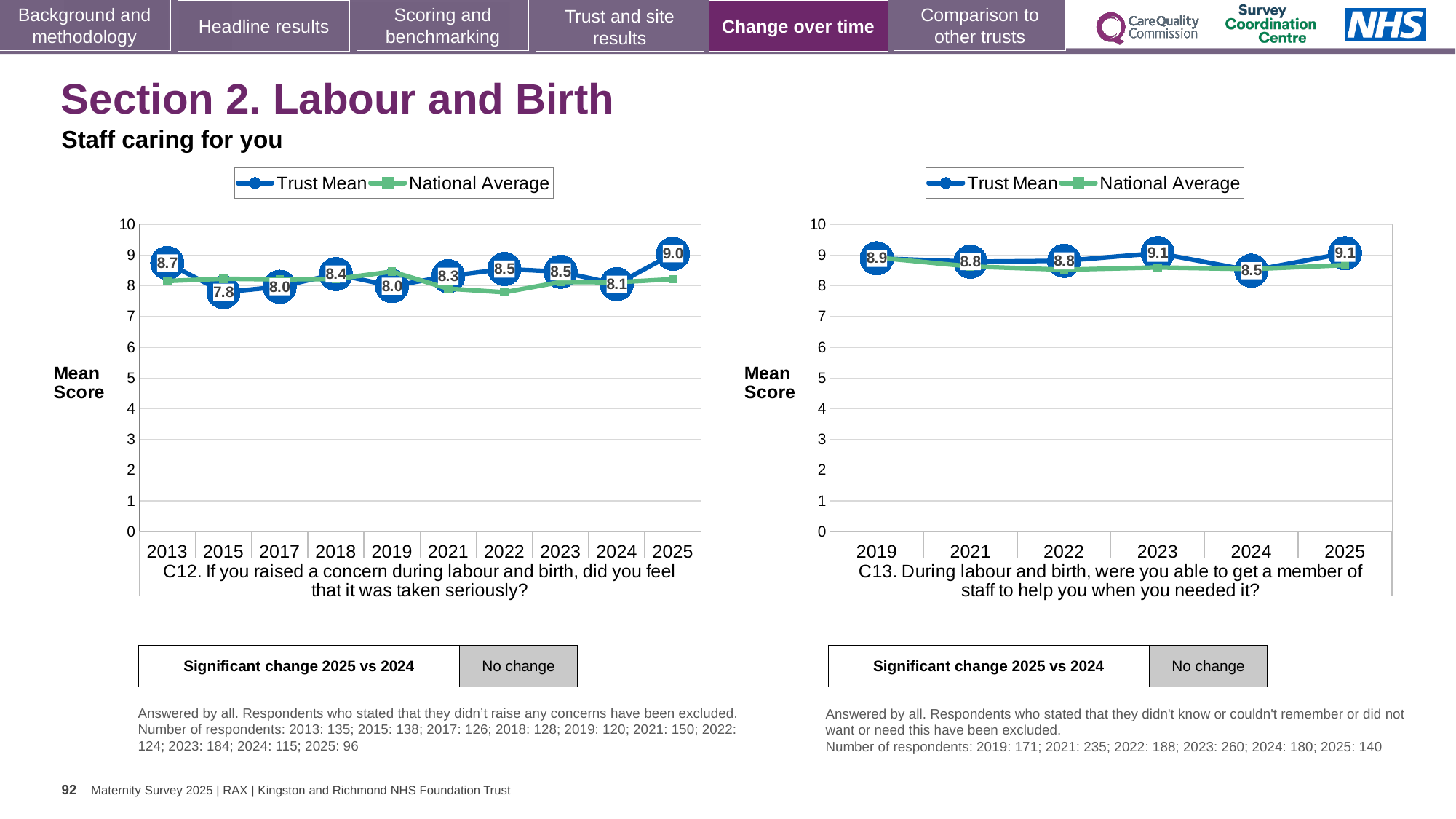
In the left chart (C12), what is the difference between the Trust Mean scores for 2025 and 2024? 0.9 In the left chart (C12), what is the Trust Mean score for 2015? 7.8 In the left chart (C12), which year has the lowest Trust Mean score? 2015 How many series does the legend of the right chart (C13) list? 2 In the right chart (C13), which year has the lowest Trust Mean score? 2024 In the left chart (C12), what is the Trust Mean score for 2025? 9.0 What type of chart is the left chart (C12)? Line chart How many years are shown on the x axis of the left chart (C12)? 10 In the right chart (C13), what is the difference between the Trust Mean scores for 2023 and 2024? 0.6 In the right chart (C13), is the Trust Mean score for 2019 greater or less than 8? greater In the left chart (C12), which year has the highest Trust Mean score? 2025 In the right chart (C13), what is the Trust Mean score for 2024? 8.5